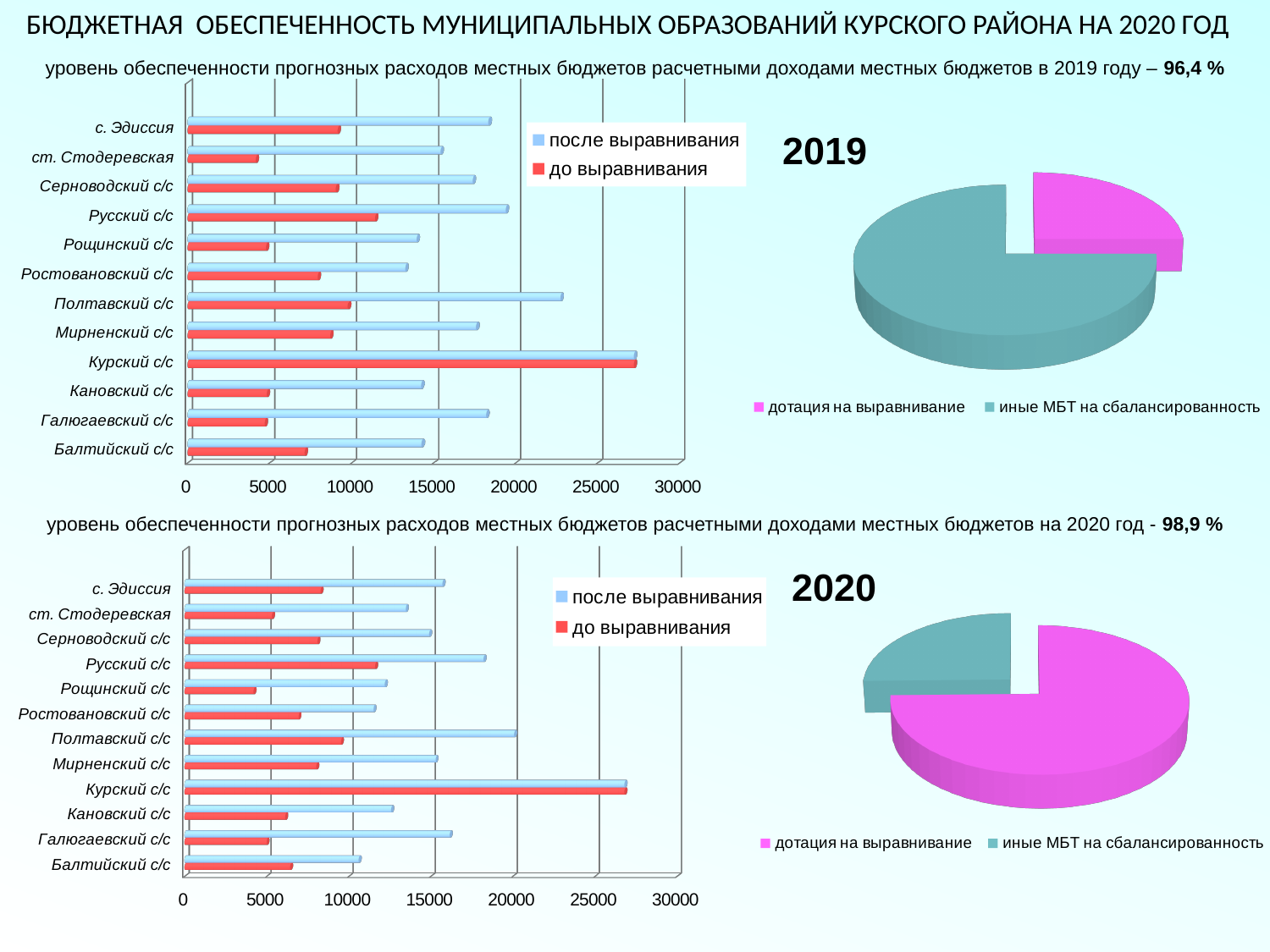
In the bottom bar chart (2020), which municipality has the highest value for 'до выравнивания'? Курский с/с In the 2020 pie chart, which slice is larger: 'дотация на выравнивание' or 'иные МБТ на сбалансированность'? дотация на выравнивание In the bottom bar chart (2020), is the 'до выравнивания' value for Рощинский с/с greater or less than 5000? less In the top bar chart (2019), is the 'до выравнивания' value for ст. Стодеревская greater or less than 5000? less In the top bar chart (2019), which municipality has the highest value for 'после выравнивания'? Курский с/с In the top bar chart (2019), is the 'после выравнивания' value for Полтавский с/с greater or less than 20000? greater What kind of chart is the chart labelled 2019 on the right? pie chart In the top bar chart (2019), which is larger for 'после выравнивания': Полтавский с/с or Мирненский с/с? Полтавский с/с In the bottom bar chart (2020), how many series does the legend list? 2 In the 2019 pie chart, which slice is larger: 'дотация на выравнивание' or 'иные МБТ на сбалансированность'? иные МБТ на сбалансированность In the top bar chart (2019), how many municipalities are listed on the vertical axis? 12 What kind of chart is the top chart on the left (2019)? bar chart